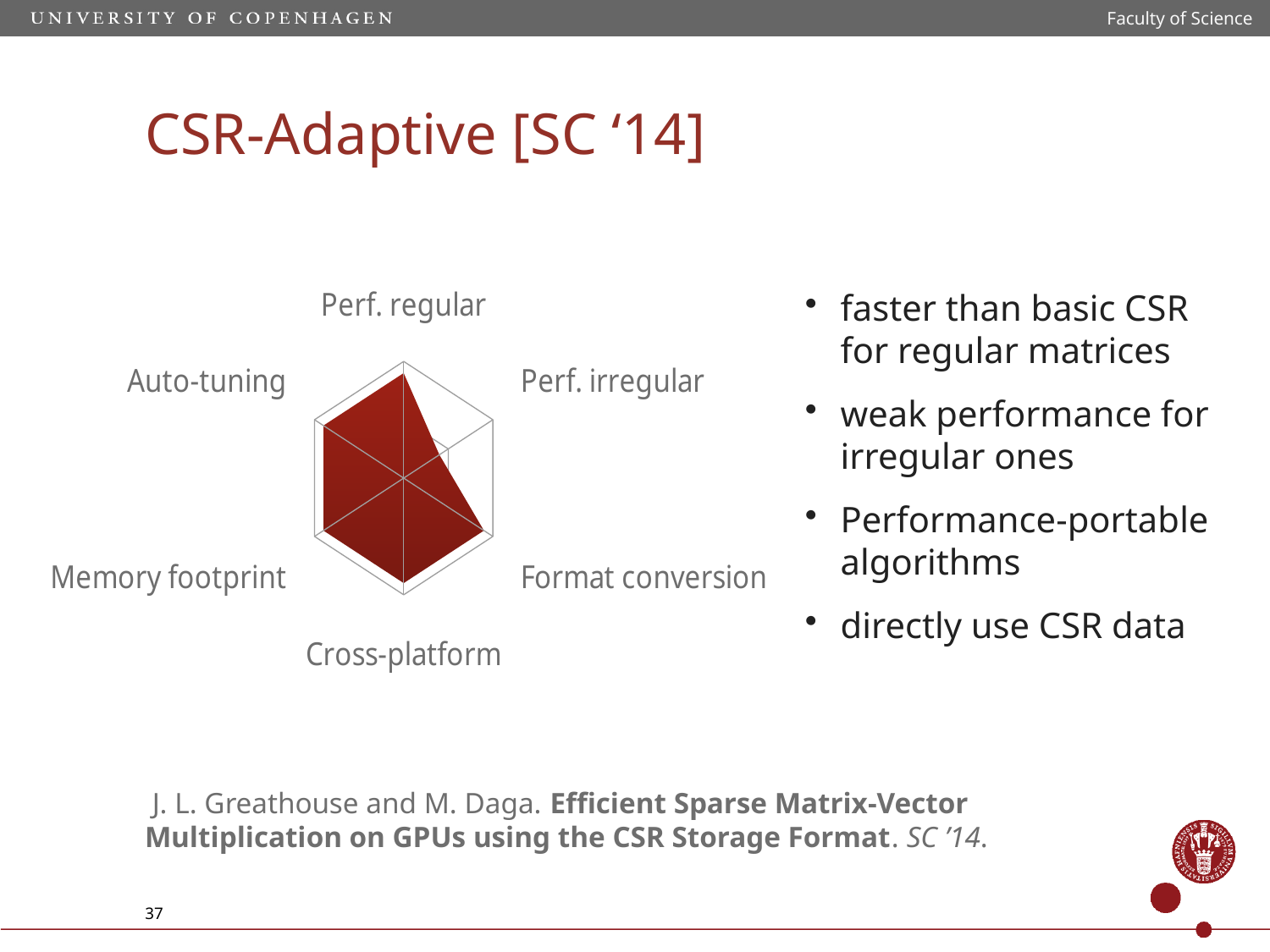
How many data series are plotted in the radar chart? 1 What colour is the filled area of the radar chart? Dark red Which is larger in the radar chart, Perf. regular or Perf. irregular? Perf. regular Which is larger in the radar chart, Format conversion or Perf. irregular? Format conversion Which category label appears at the top of the radar chart? Perf. regular Which category has the lowest value in the radar chart? Perf. irregular What kind of chart is shown on the slide? Radar chart Which is larger in the radar chart, Perf. irregular or Cross-platform? Cross-platform How many categories (axes) does the radar chart have? 6